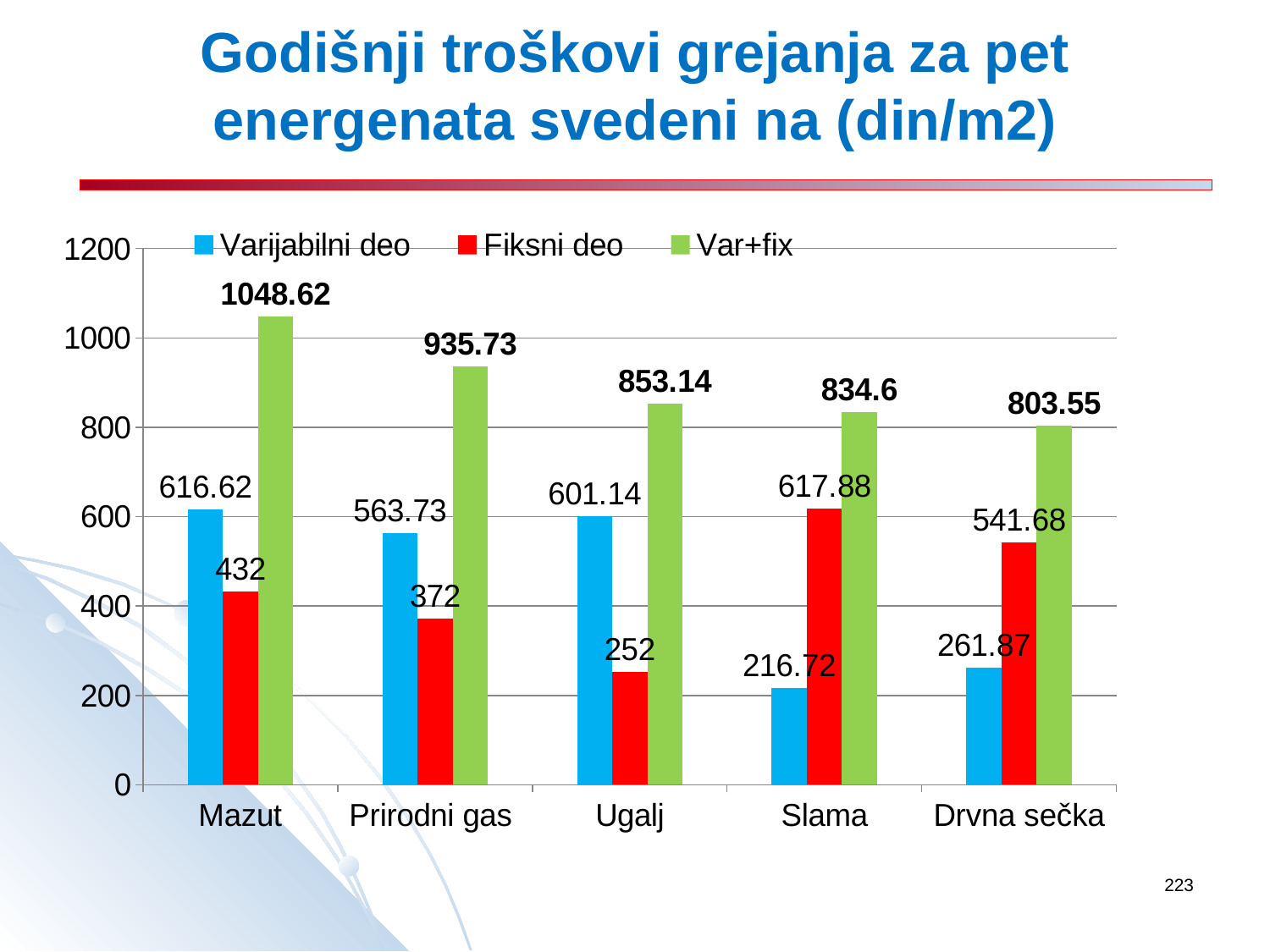
What is the Fiksni deo value for Slama? 617.88 How many series does the legend list? 3 Which category has the lowest Varijabilni deo value? Slama What is the Var+fix value for Mazut? 1048.62 How many categories are shown on the x axis? 5 What kind of chart is shown on the slide? bar chart Is the Var+fix value for Slama greater or less than 800? greater Which is larger, the Fiksni deo value for Mazut or for Drvna sečka? Drvna sečka What is the Varijabilni deo value for Ugalj? 601.14 What is the difference between the Var+fix values for Mazut and Drvna sečka? 245.07 What is the Fiksni deo value for Prirodni gas? 372 Which category has the highest Var+fix value? Mazut